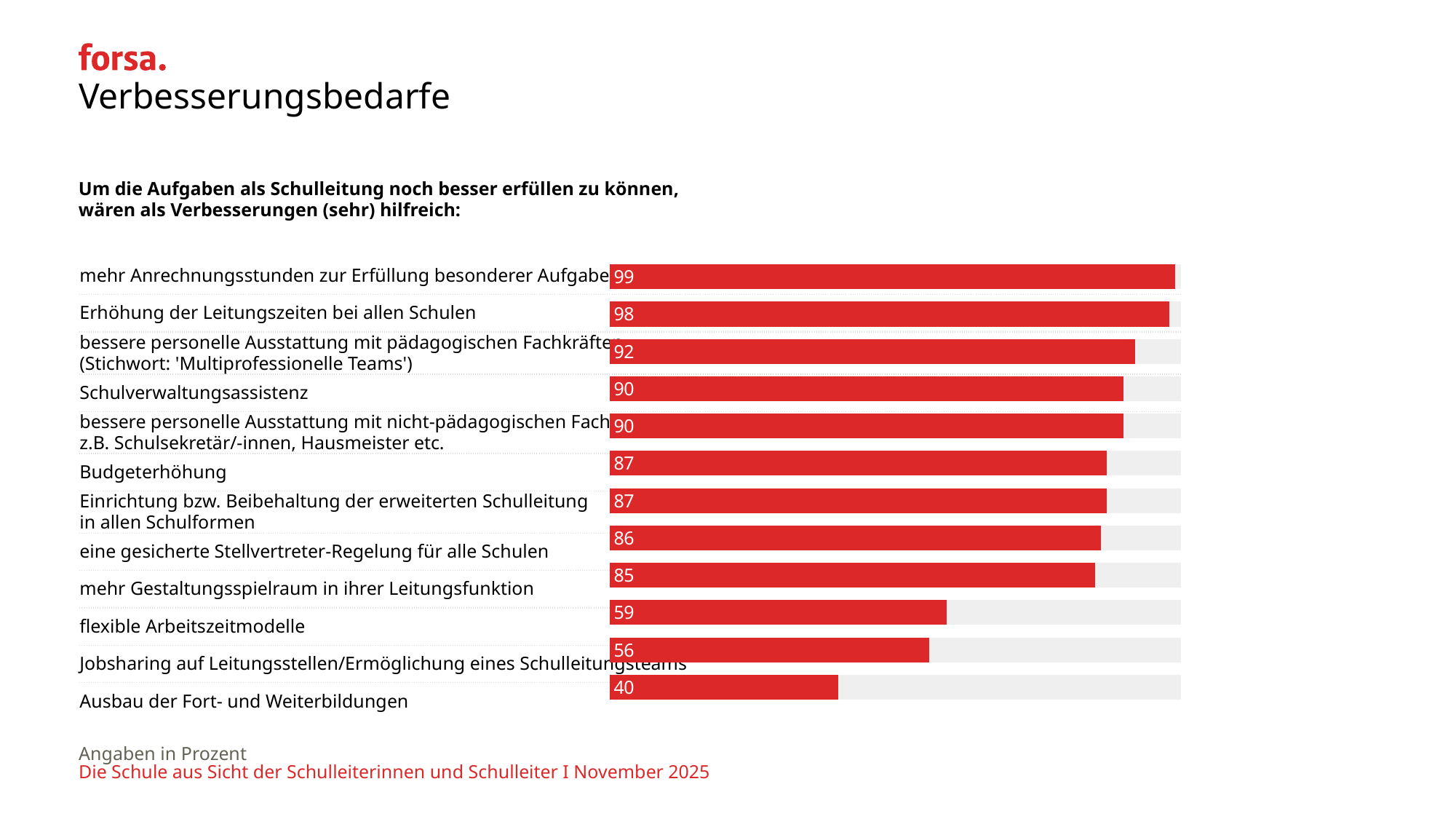
How many categories are shown in the chart? 12 What is the difference between the values for "flexible Arbeitszeitmodelle" and "Jobsharing auf Leitungsstellen/Ermöglichung eines Schulleitungsteams"? 3 What is the value for "Ausbau der Fort- und Weiterbildungen"? 40 What kind of chart is shown on the slide? bar chart What is the value for "Schulverwaltungsassistenz"? 90 What is the value for "flexible Arbeitszeitmodelle"? 59 Which category has the highest value? mehr Anrechnungsstunden zur Erfüllung besonderer Aufgaben In what unit are the values given, according to the note below the chart? Prozent What is the value for "Budgeterhöhung"? 87 What is the difference between the values for "Erhöhung der Leitungszeiten bei allen Schulen" and "Ausbau der Fort- und Weiterbildungen"? 58 Which is larger: the value for "mehr Gestaltungsspielraum in ihrer Leitungsfunktion" or the value for "flexible Arbeitszeitmodelle"? mehr Gestaltungsspielraum in ihrer Leitungsfunktion Which category has the lowest value? Ausbau der Fort- und Weiterbildungen